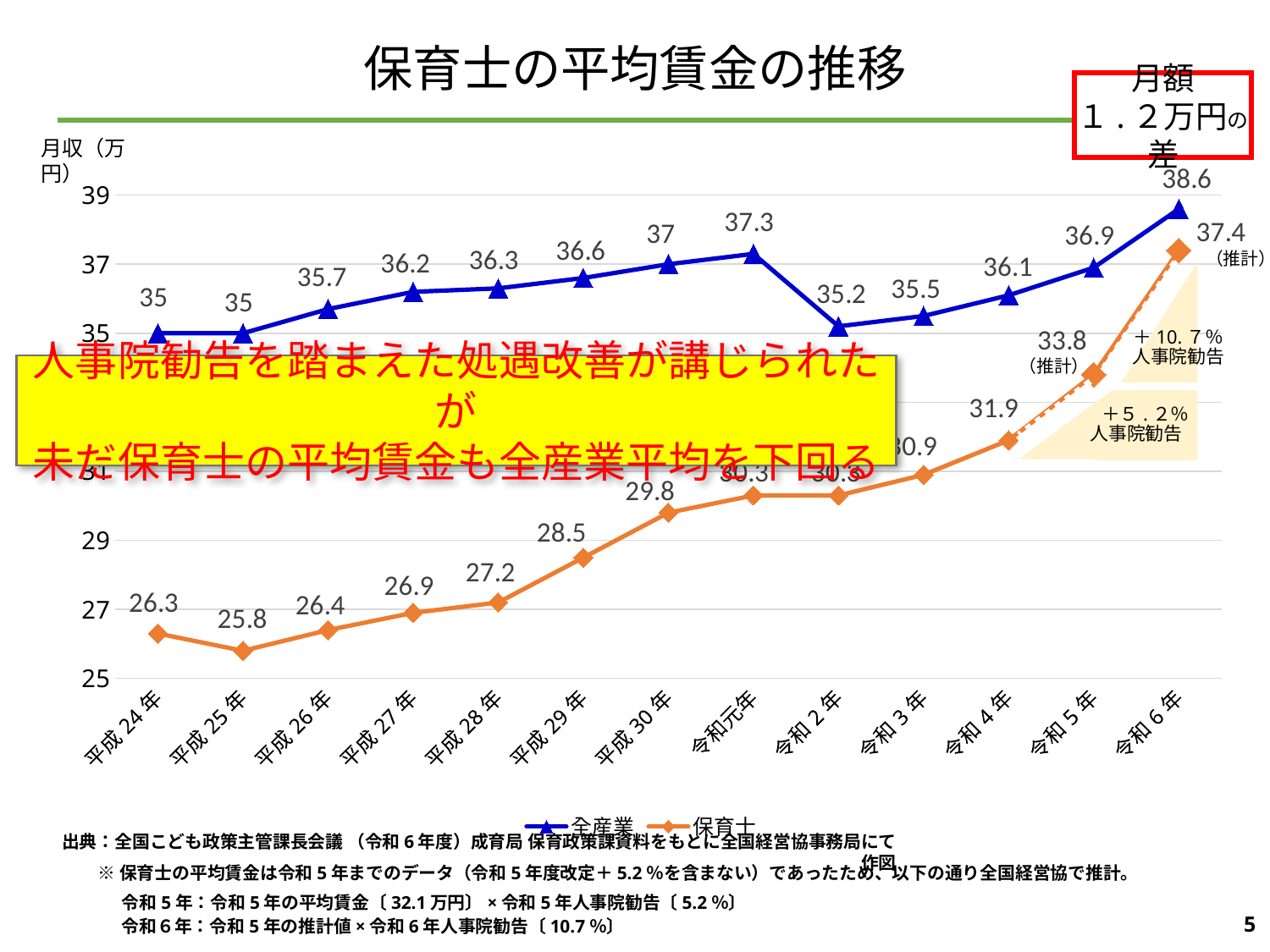
In which year is the 全産業 value highest? 令和6年 What is the difference between the 保育士 values in 令和5年 and 令和4年? 1.9 How many years are shown on the x axis? 13 How many series does the legend list? 2 Which is larger in 平成30年, the 全産業 value or the 保育士 value? 全産業 What type of chart is shown on the slide? line chart What is the value for 全産業 in 令和元年? 37.3 What is the difference between the 全産業 and 保育士 values in 令和6年? 1.2 What is the value for 全産業 in 令和6年? 38.6 What is the value for 保育士 in 令和4年? 31.9 In which year is the 保育士 value lowest? 平成25年 What is the value for 保育士 in 平成24年? 26.3